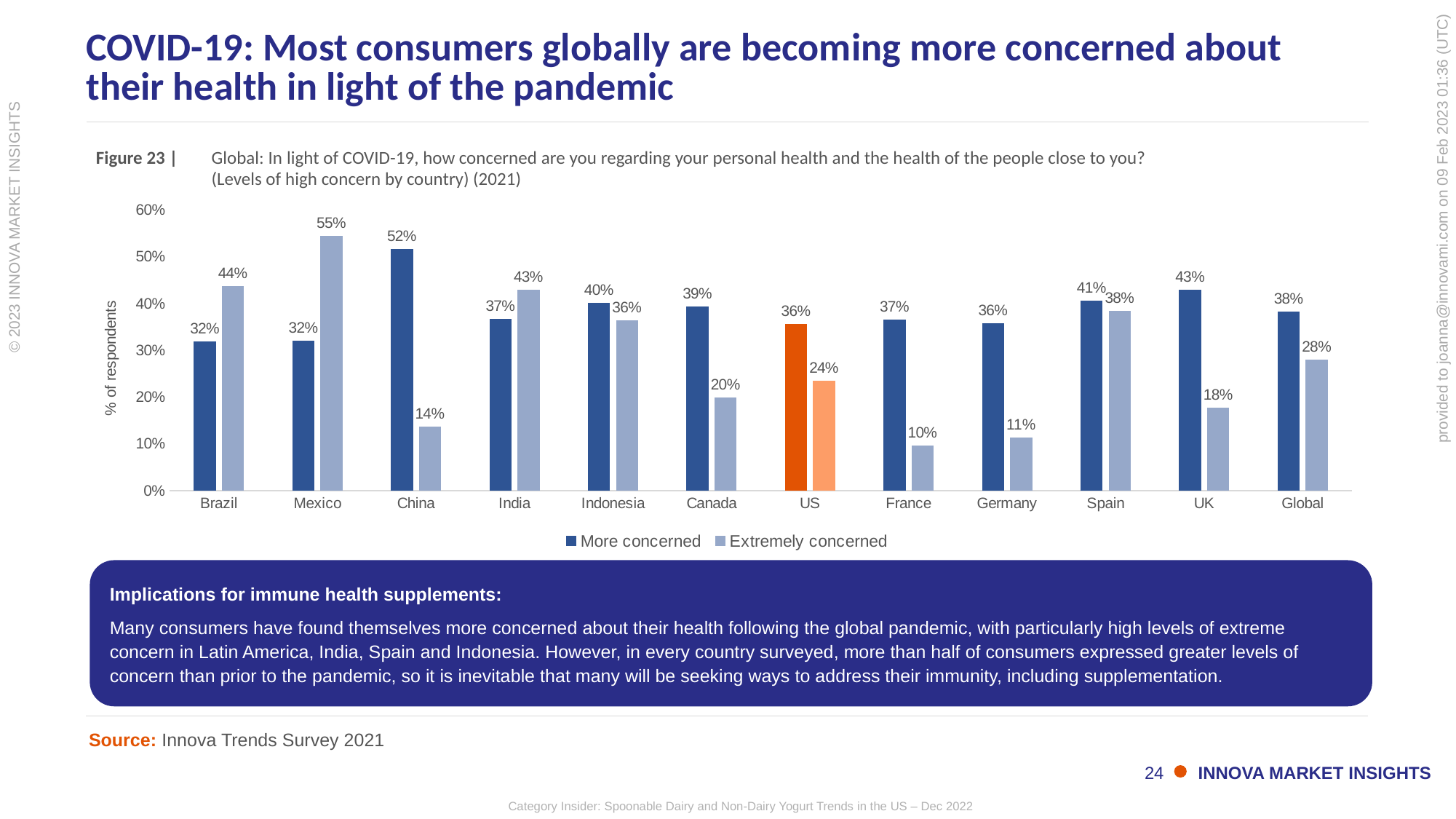
Which country has the lowest 'Extremely concerned' value? France How many countries/categories are shown on the x axis? 12 What is the 'More concerned' value for China? 52% What is the 'Extremely concerned' value for the US? 24% What is the difference between the 'More concerned' and 'Extremely concerned' values for China? 38% What is the 'Extremely concerned' value for Mexico? 55% Which country has the highest 'More concerned' value? China Which category's bars are highlighted in orange? US How many series does the legend list? 2 Which country has the highest 'Extremely concerned' value? Mexico Which is larger for Brazil: 'More concerned' or 'Extremely concerned'? Extremely concerned What kind of chart is shown on the slide? Bar chart